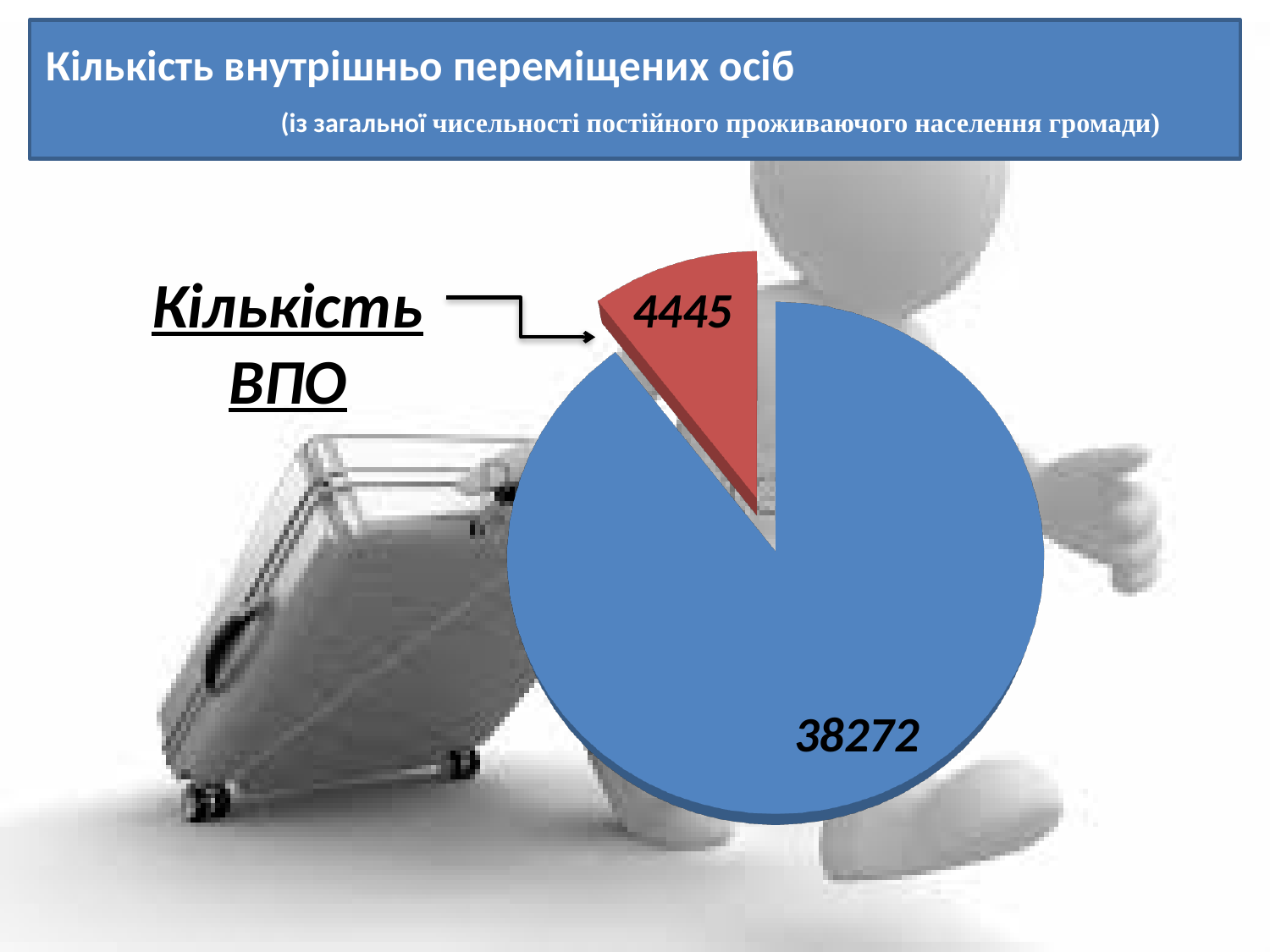
What colour is the slice labelled "Кількість ВПО"? red What kind of chart is shown on the slide? pie chart Which slice of the pie chart is the smallest? 4445 (Кількість ВПО) Which slice of the pie chart is the largest? 38272 (blue slice) What is the total of the two slice values in the pie chart? 42717 What is the difference between the two slice values, 38272 and 4445? 33827 What value is shown for the slice labelled "Кількість ВПО"? 4445 What value is printed on the large blue slice of the pie chart? 38272 Which is larger: the slice with 4445 or the slice with 38272? 38272 What value is printed on the red slice of the pie chart? 4445 How many slices does the pie chart have? 2 What share of the pie does the "Кількість ВПО" slice (4445) represent? 10.4%